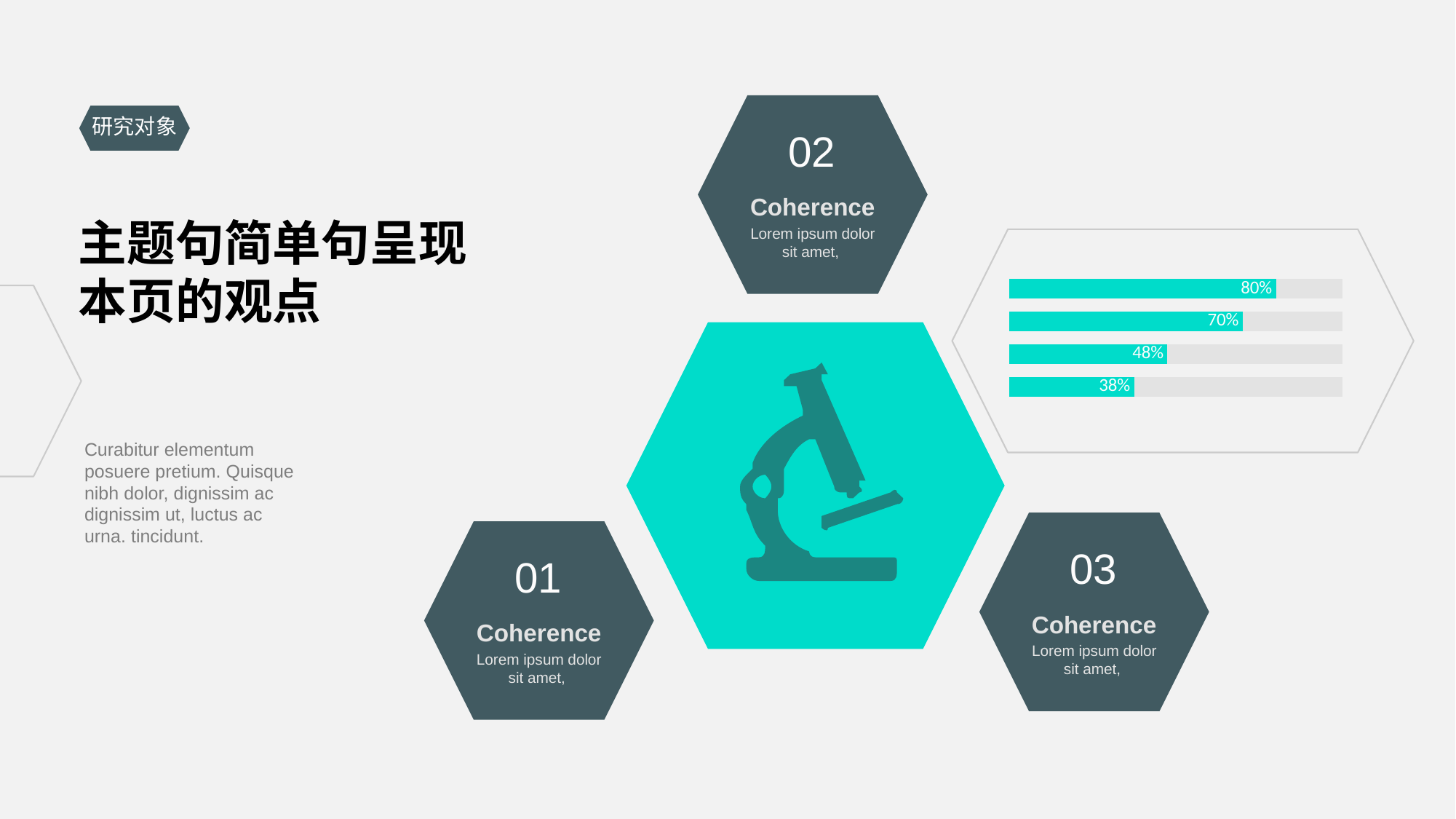
What kind of chart is shown on the right side of the slide? bar chart What is the difference between the second bar (70%) and the third bar (48%) in the chart? 22% What is the difference between the top bar's value and the bottom bar's value in the chart? 42% What is the value shown on the bottom bar of the chart? 38% Which bar in the chart has the highest value? the top bar (80%) What is the value shown on the third bar from the top of the chart? 48% Which is larger in the chart, the third bar from the top or the bottom bar? the third bar from the top (48%) What is the value shown on the top bar of the chart? 80% How many bars does the chart on the right side of the slide have? 4 Which bar in the chart has the lowest value? the bottom bar (38%) Do the bar values in the chart increase or decrease from top to bottom? decrease What is the value shown on the second bar from the top of the chart? 70%